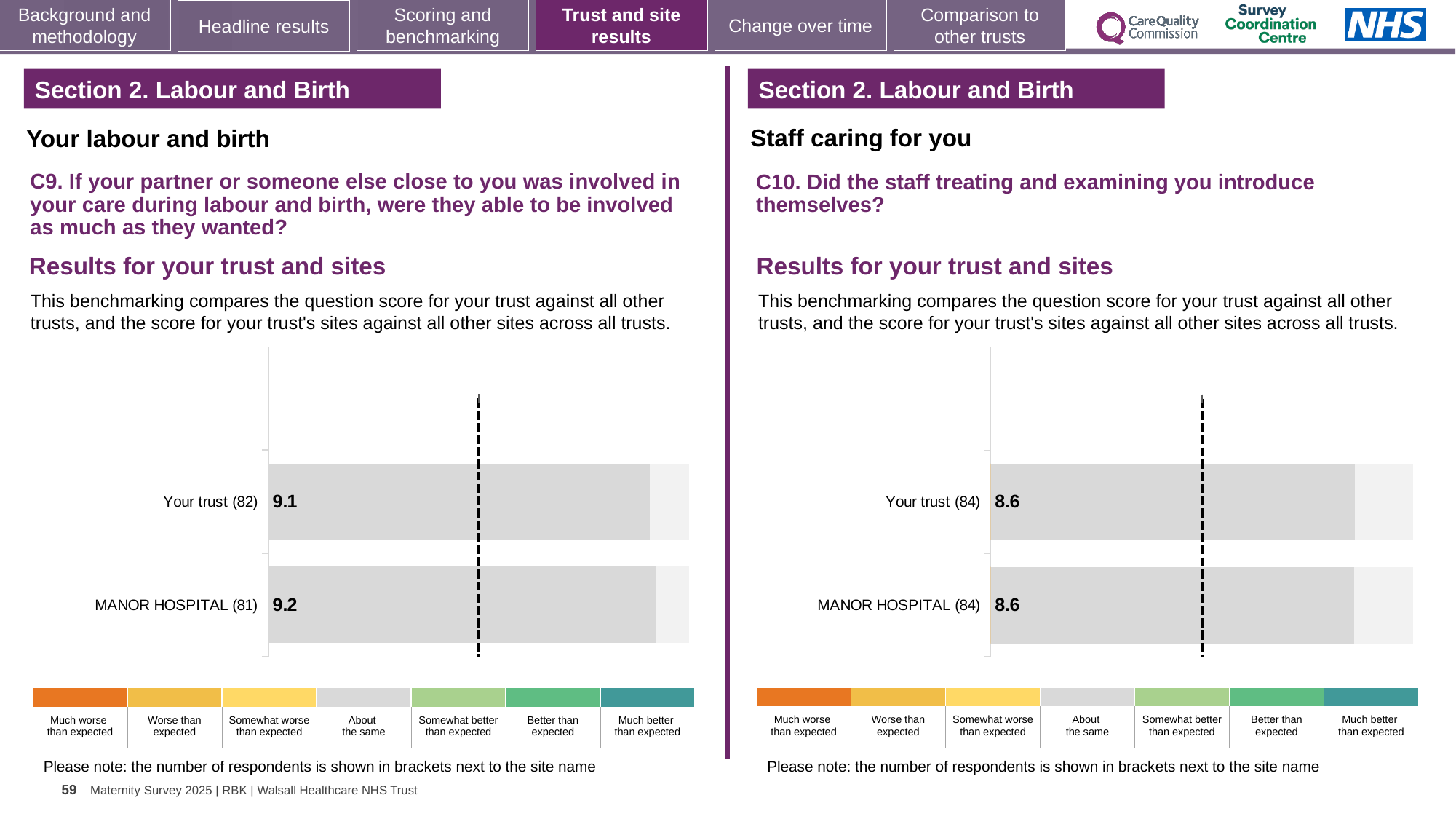
In the C10 chart on the right, what is the score for MANOR HOSPITAL? 8.6 In the C10 chart on the right, what is the difference between the Your trust score and the MANOR HOSPITAL score? 0 In the C9 chart on the left, how many respondents are shown in brackets for MANOR HOSPITAL? 81 How many bars are plotted in the C9 chart on the left? 2 In the C10 chart on the right, how many respondents are shown in brackets for Your trust? 84 In the C9 chart on the left, what is the score for Your trust? 9.1 In the C9 chart on the left, what is the difference between the MANOR HOSPITAL score and the Your trust score? 0.1 In the C9 chart on the left, which bar has the lowest score? Your trust (82) What type of chart is used in the C10 chart on the right? Bar chart In the C9 chart on the left, which has the higher score, Your trust or MANOR HOSPITAL? MANOR HOSPITAL In the C10 chart on the right, what is the score for Your trust? 8.6 In the C9 chart on the left, what is the score for MANOR HOSPITAL? 9.2